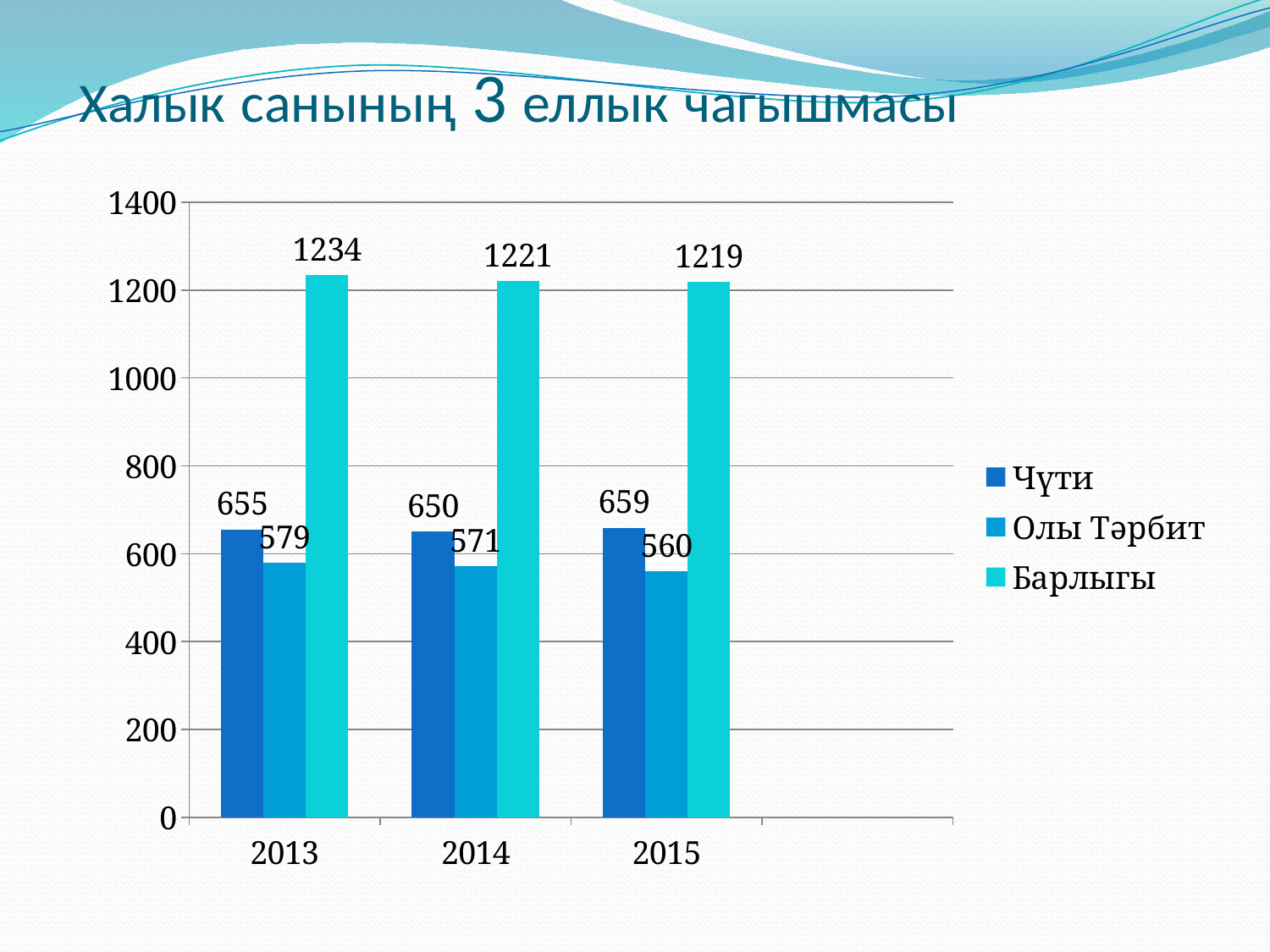
Is the value for Барлыгы in 2015 greater or less than 1200? greater Do the Барлыгы values rise or fall from 2013 to 2015? fall How many series does the legend list? 3 How many years are shown on the x axis? 3 What kind of chart is shown on the slide? bar chart In which year is the Олы Тәрбит value lowest? 2015 Which is larger in 2014: Чүти or Олы Тәрбит? Чүти What is the value for Олы Тәрбит in 2015? 560 What is the difference between the Барлыгы values for 2013 and 2015? 15 What is the value for Барлыгы in 2014? 1221 In which year is the Барлыгы value highest? 2013 What is the value for Чүти in 2013? 655